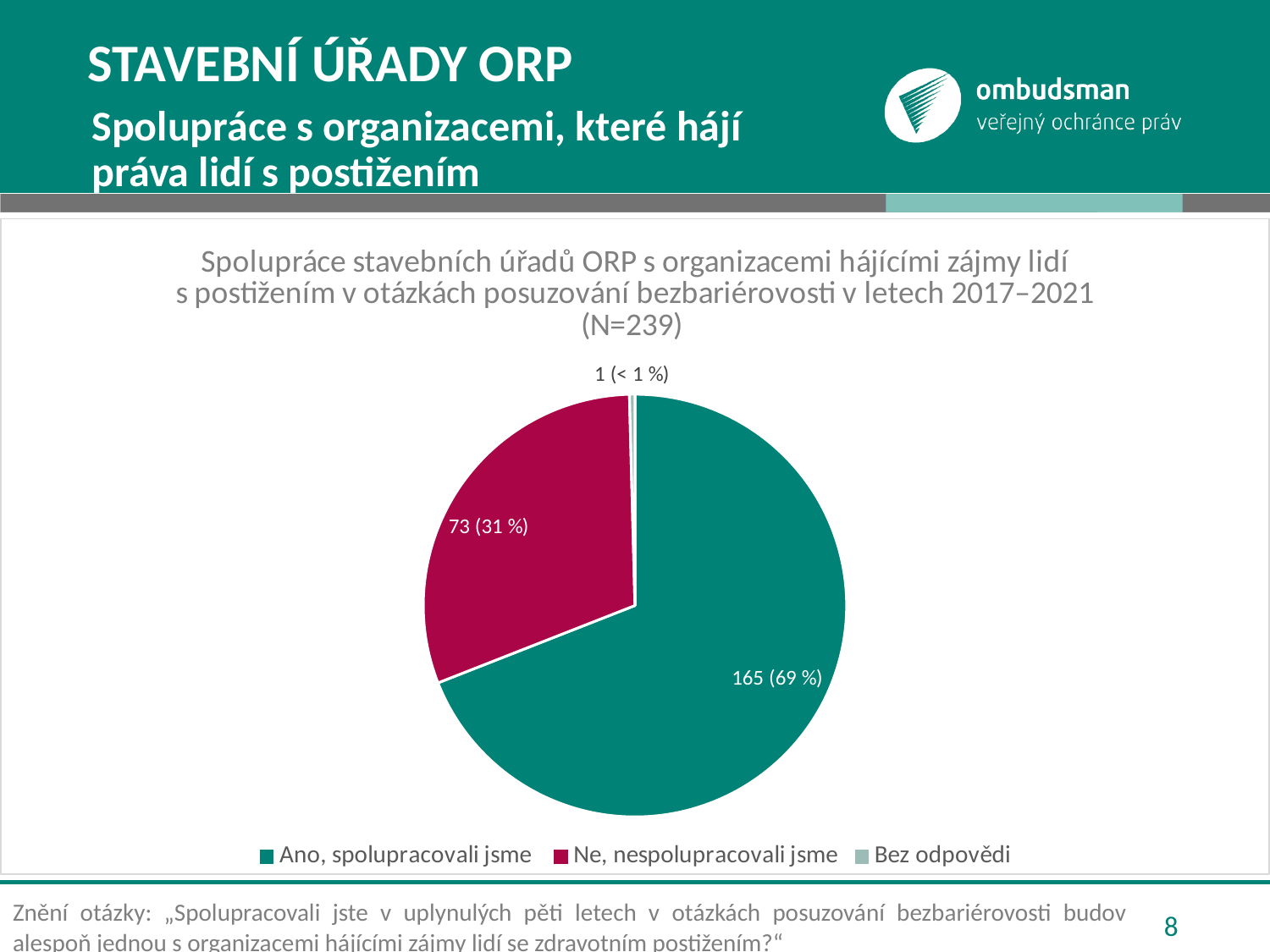
What is the data label for the slice "Ano, spolupracovali jsme"? 165 (69 %) What is the data label for the slice "Bez odpovědi"? 1 (< 1 %) What is the data label for the slice "Ne, nespolupracovali jsme"? 73 (31 %) How many entries does the legend list? 3 Which is larger, the count for "Ne, nespolupracovali jsme" or for "Bez odpovědi"? Ne, nespolupracovali jsme What is the N value stated in the chart title? N=239 How many slices does the pie chart have? 3 What share of the pie does "Ano, spolupracovali jsme" represent? 69 % Which category has the smallest slice? Bez odpovědi What is the difference in count between "Ano, spolupracovali jsme" and "Ne, nespolupracovali jsme"? 92 Which category has the largest slice? Ano, spolupracovali jsme What type of chart is shown on the slide? pie chart